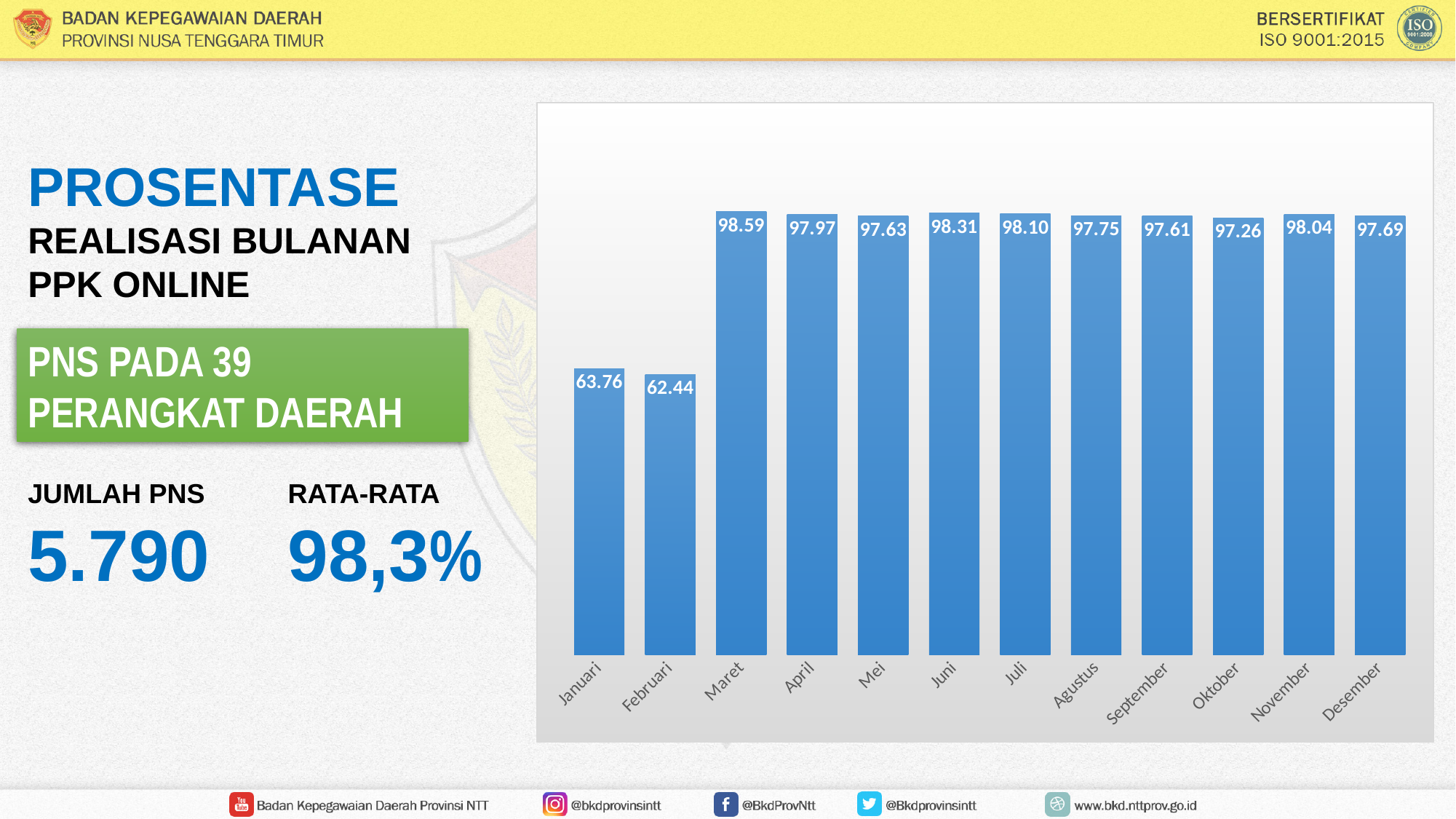
Which month has the highest value in the bar chart? Maret What is the value for Oktober in the bar chart? 97.26 What kind of chart is shown on the slide? Bar chart What is the value for Maret in the bar chart? 98.59 Does the value rise or fall from Februari to Maret? Rise What is the difference between the values for Januari and Februari? 1.32 What is the value for Desember in the bar chart? 97.69 Which is larger, the value for Januari or the value for Februari? Januari How many months are shown in the bar chart? 12 What is the value for Februari in the bar chart? 62.44 What is the difference between the values for Maret and Februari? 36.15 Which month has the lowest value in the bar chart? Februari